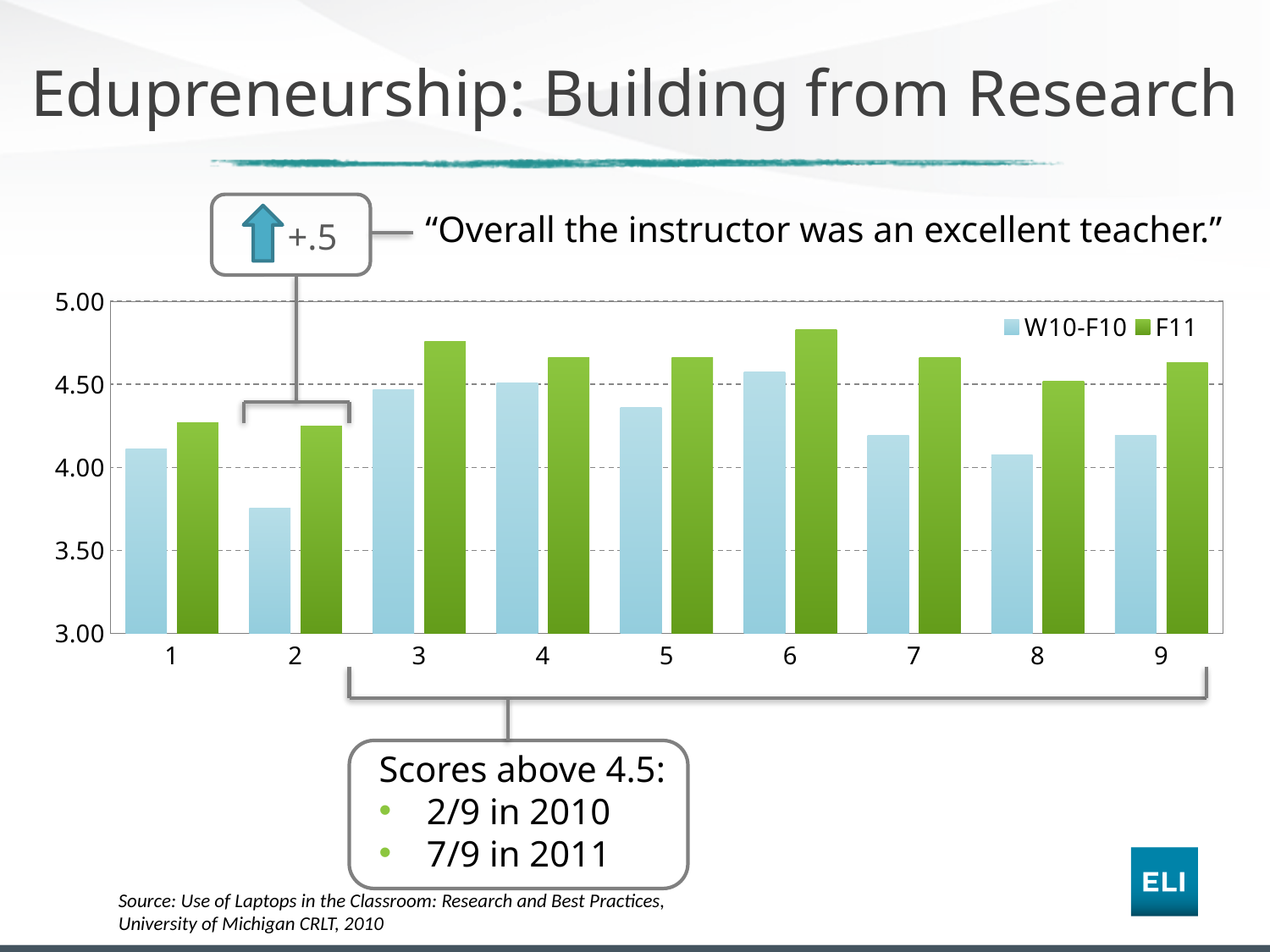
Which category has the lowest W10-F10 value? 2 Which series is drawn in green in the chart? F11 How many series does the chart's legend list? 2 Is the W10-F10 value for category 7 greater or less than 4.50? less Is the F11 value for category 3 greater or less than 4.50? greater How many categories are shown along the x axis of the chart? 9 What kind of chart is shown on the slide? bar chart For category 2, which series has the larger value, W10-F10 or F11? F11 Is the F11 value for category 6 greater or less than 4.50? greater What are the two series named in the chart's legend? W10-F10 and F11 For category 9, which series has the larger value, W10-F10 or F11? F11